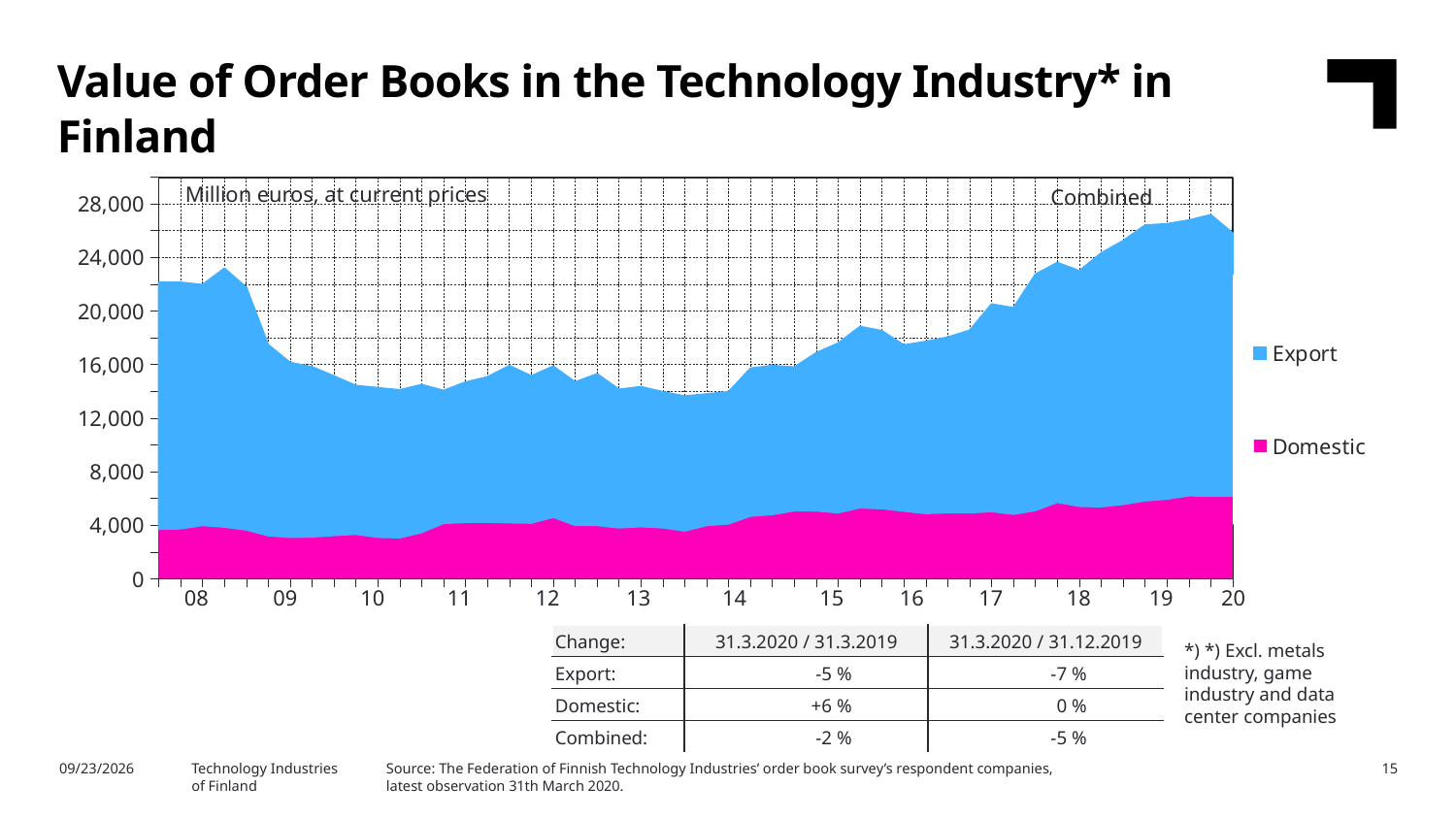
Is the combined value around 2014 greater or less than 16,000? less How many series does the legend list? 2 What kind of chart is shown on the slide? Stacked area chart Does the combined value rise or fall between 2014 and 2019? rise Does the combined value rise or fall between 2008 and 2010? fall Is the Domestic value around 2010 greater or less than 4,000? less Is the combined value at the end of the series (2020) greater or less than 24,000? greater How many year labels are shown on the x axis? 13 What unit is stated in the label at the top of the chart? Million euros, at current prices Which two series are listed in the chart legend? Export and Domestic